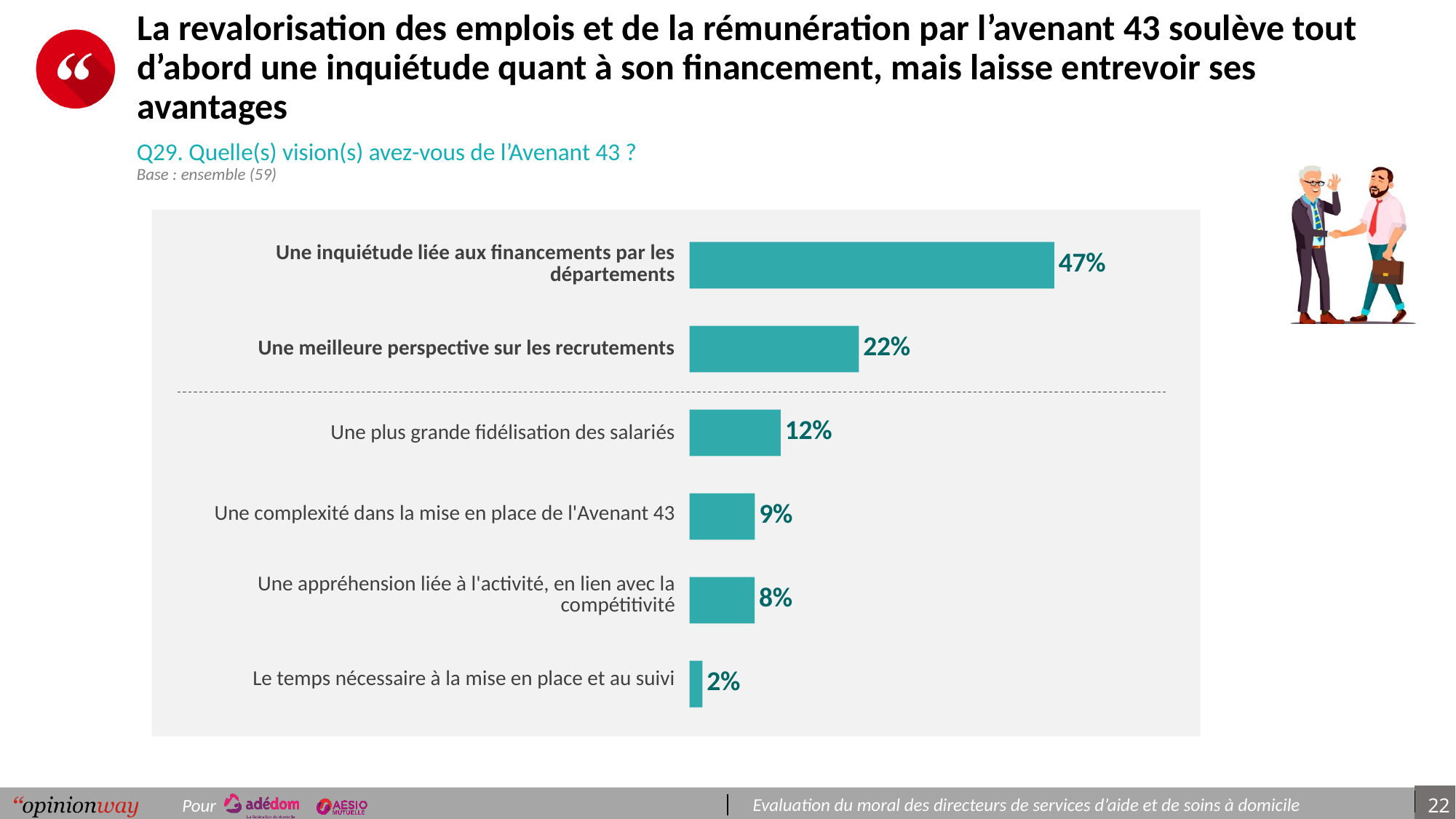
What value is shown for "Le temps nécessaire à la mise en place et au suivi"? 2% Which category has the highest value? Une inquiétude liée aux financements par les départements What is the base (number of respondents) indicated for the chart? 59 Which is larger: the value for "Une complexité dans la mise en place de l'Avenant 43" or for "Une appréhension liée à l'activité, en lien avec la compétitivité"? Une complexité dans la mise en place de l'Avenant 43 What is the difference between the values for "Une inquiétude liée aux financements par les départements" and "Une meilleure perspective sur les recrutements"? 25 percentage points Which category has the lowest value? Le temps nécessaire à la mise en place et au suivi What is the question number shown above the chart? Q29 How many categories are shown in the chart? 6 What percentage is shown for "Une inquiétude liée aux financements par les départements"? 47% What percentage is shown for "Une plus grande fidélisation des salariés"? 12% What value is shown for "Une meilleure perspective sur les recrutements"? 22% What kind of chart is shown on the slide? Bar chart